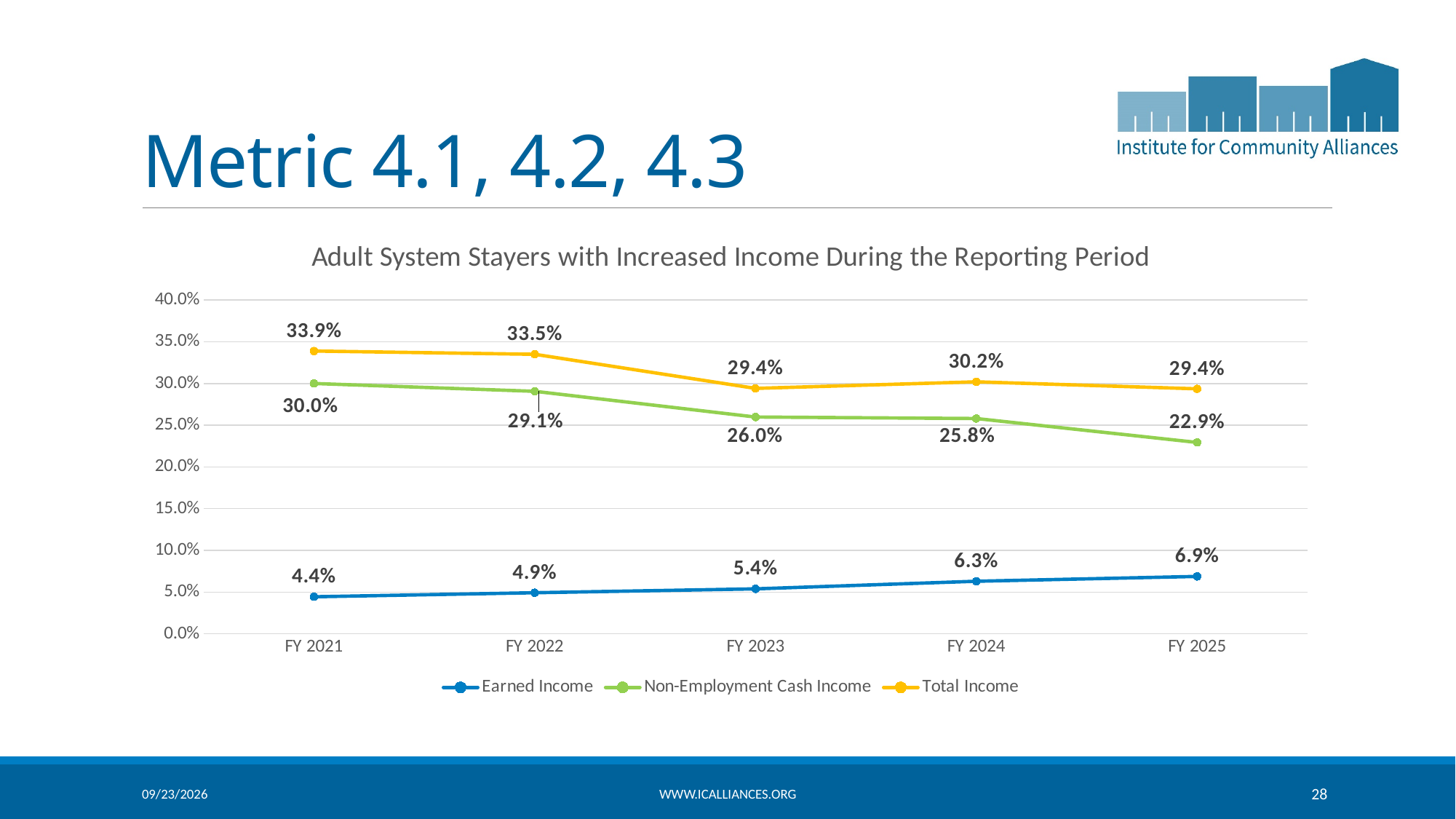
In which fiscal year is Non-Employment Cash Income lowest? FY 2025 What is the Non-Employment Cash Income value for FY 2025? 22.9% What is the title of the chart? Adult System Stayers with Increased Income During the Reporting Period What is the Total Income value for FY 2021? 33.9% What kind of chart is shown on the slide? Line chart How many fiscal years are shown on the x axis? 5 How many series does the legend list? 3 In which fiscal year is Earned Income highest? FY 2025 Does Earned Income rise or fall from FY 2021 to FY 2025? Rise What is the difference between Total Income in FY 2021 and FY 2025? 4.5% Which is larger: Non-Employment Cash Income in FY 2022 or in FY 2024? FY 2022 What is the Earned Income value for FY 2023? 5.4%